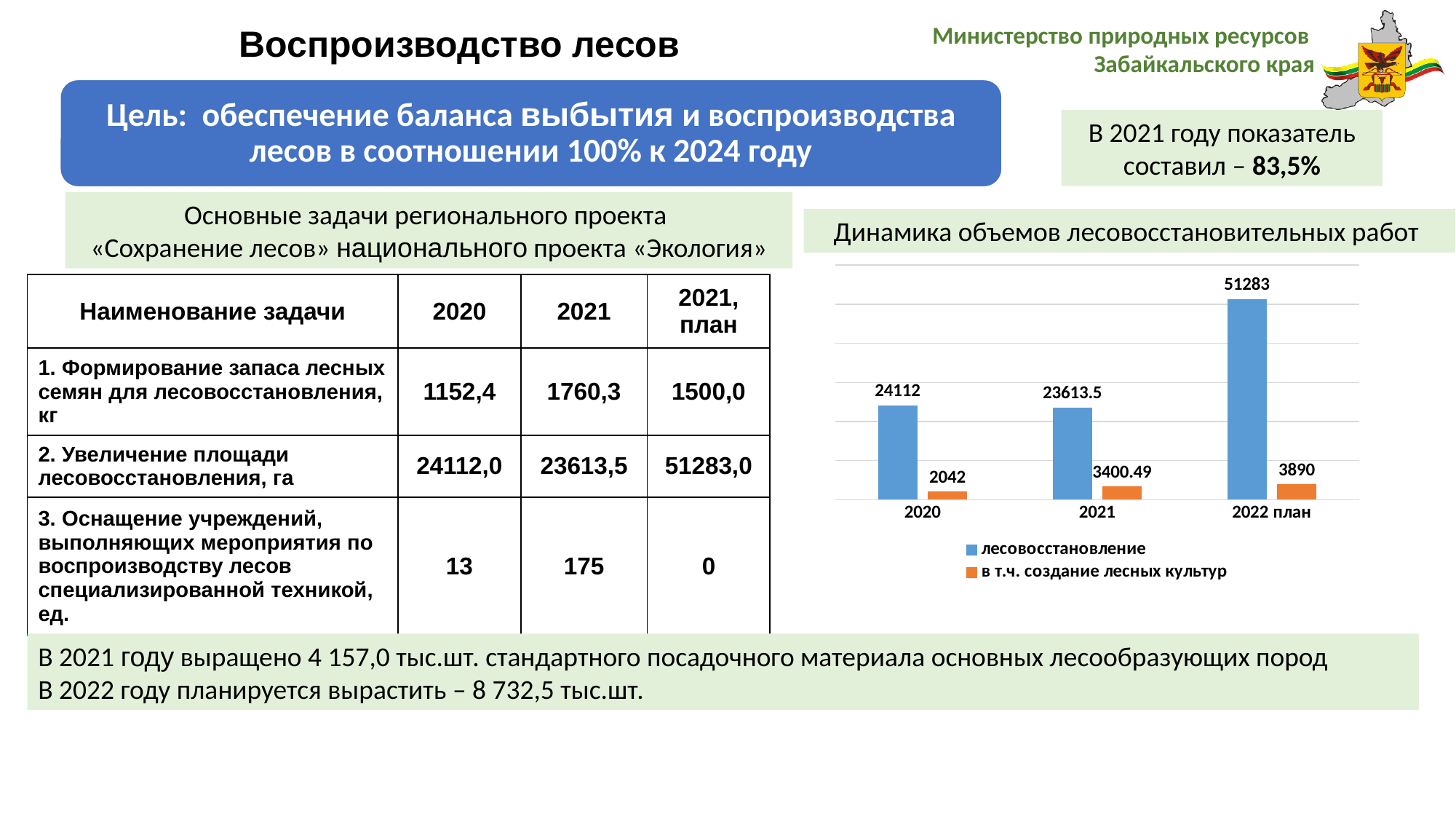
What type of chart is shown on the slide? bar chart What is the value of лесовосстановление for 2021 in the chart? 23613.5 How many categories are shown on the x axis of the chart? 3 What is the value of в т.ч. создание лесных культур for 2021 in the chart? 3400.49 Which category has the highest value for лесовосстановление? 2022 план How many series does the chart legend list? 2 Which is larger: в т.ч. создание лесных культур for 2022 план or for 2021? 2022 план What is the difference between the лесовосстановление values for 2022 план and 2021? 27669.5 Which category has the lowest value for в т.ч. создание лесных культур? 2020 What is the value of в т.ч. создание лесных культур for 2022 план in the chart? 3890 What is the value of лесовосстановление for 2020 in the chart? 24112 What is the value of лесовосстановление for 2022 план in the chart? 51283